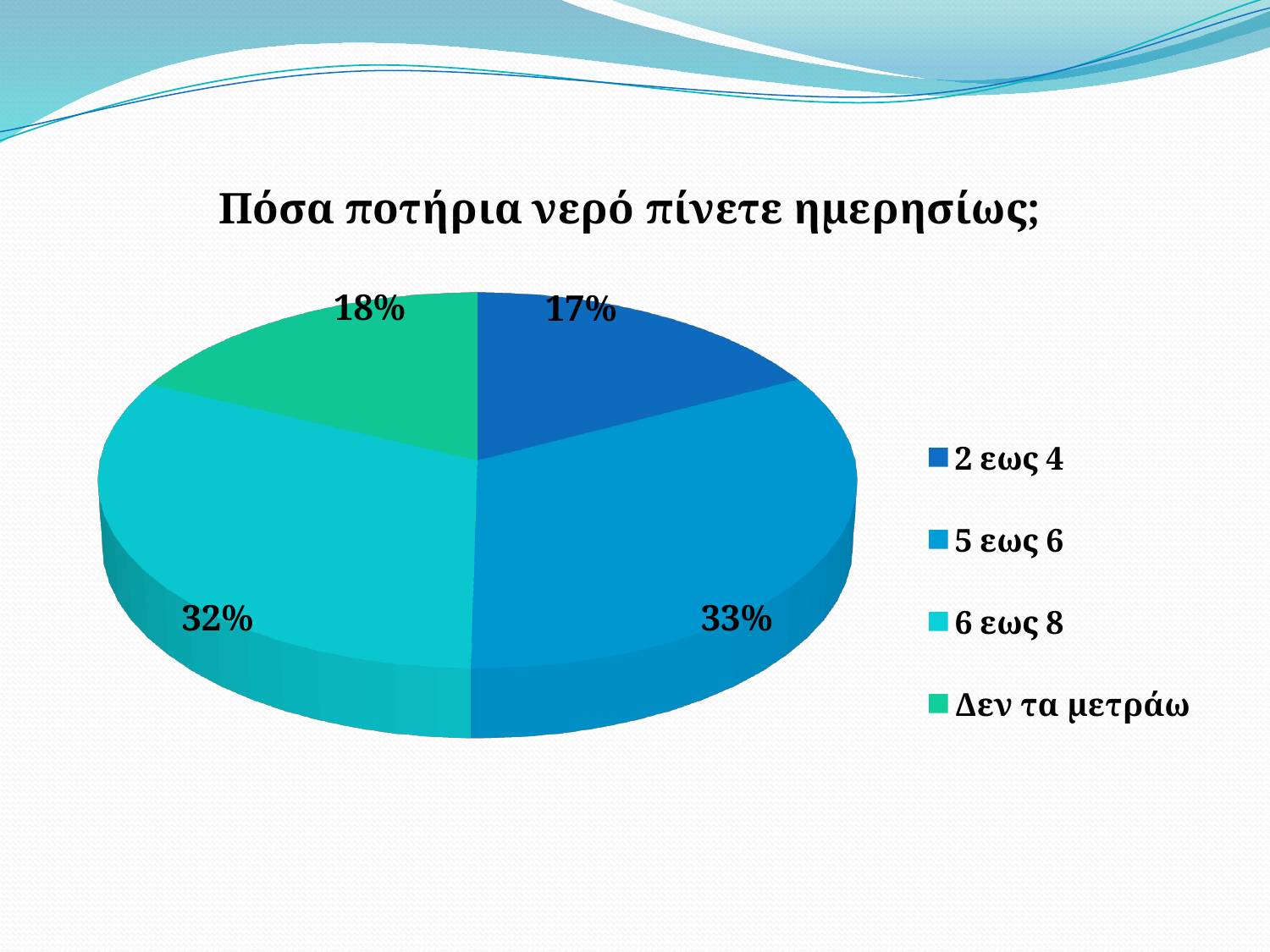
Which is larger, the share for "Δεν τα μετράω" or the share for "2 εως 4"? Δεν τα μετράω Which legend entry is shown in green? Δεν τα μετράω What percentage is shown for the "6 εως 8" category? 32% What share of the pie does the "Δεν τα μετράω" slice represent? 18% Which category has the largest share of the pie? 5 εως 6 What is the difference in percentage points between the "5 εως 6" and "2 εως 4" slices? 16 What kind of chart is shown on the slide? Pie chart Which category has the smallest share of the pie? 2 εως 4 What percentage is shown for the "2 εως 4" category? 17% How many categories does the pie chart show? 4 What share of the pie does the "5 εως 6" slice represent? 33% What is the title of the chart? Πόσα ποτήρια νερό πίνετε ημερησίως;